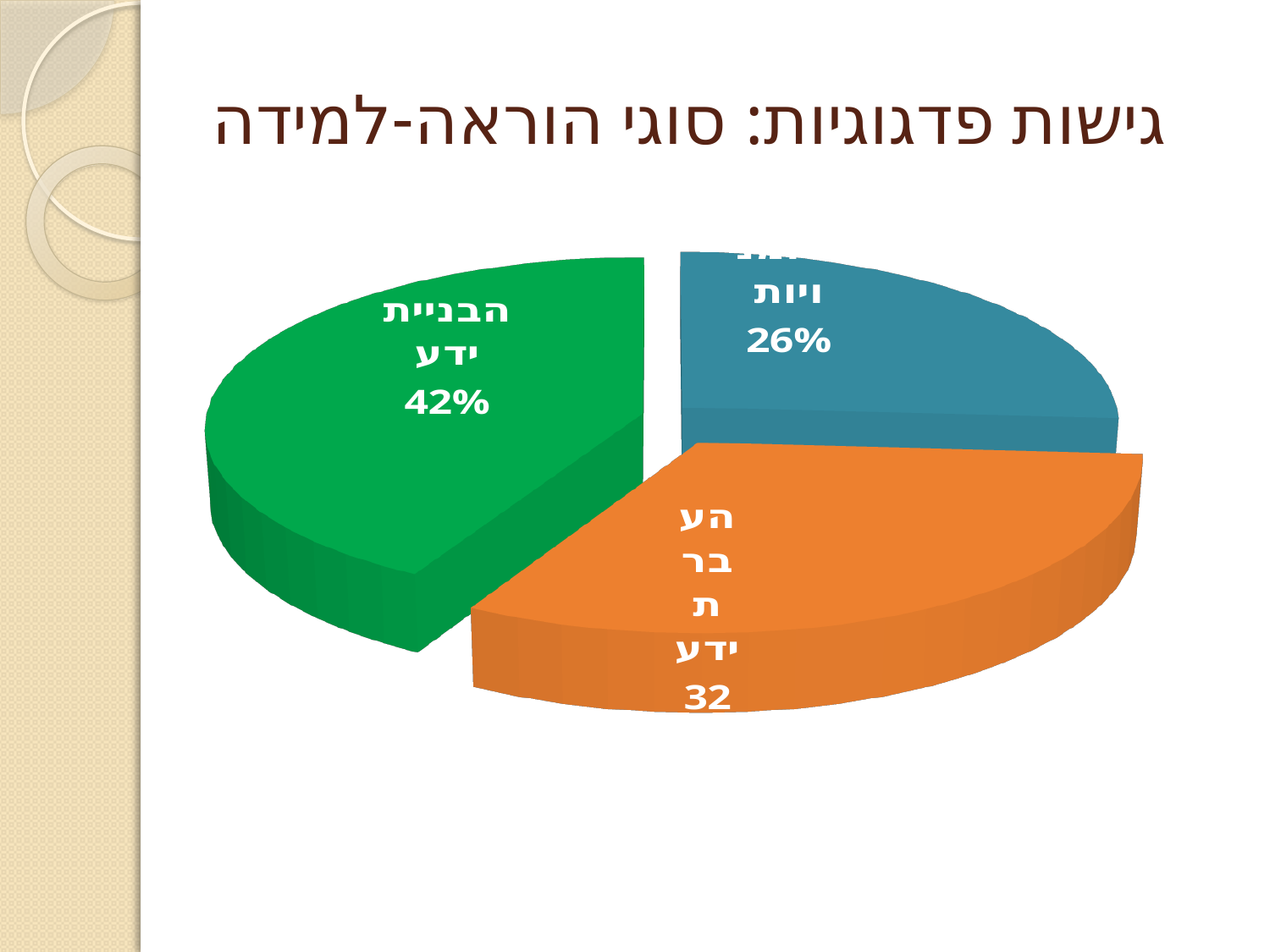
What number is printed on the orange slice labelled העברת ידע? 32 What is the smallest percentage shown on the pie chart? 26% What share of the pie does the green slice represent? 42% What colour is the slice for הבניית ידע? Green Which slice has the largest share of the pie? הבניית ידע How many slices does the pie chart have? 3 What is the difference between the largest slice (42%) and the smallest slice (26%)? 16% Which is larger, the share for הבניית ידע or the share for העברת ידע? הבניית ידע What kind of chart is shown on the slide? Pie chart What percentage is shown for הבניית ידע? 42% What is the title of the slide? גישות פדגוגיות: סוגי הוראה-למידה